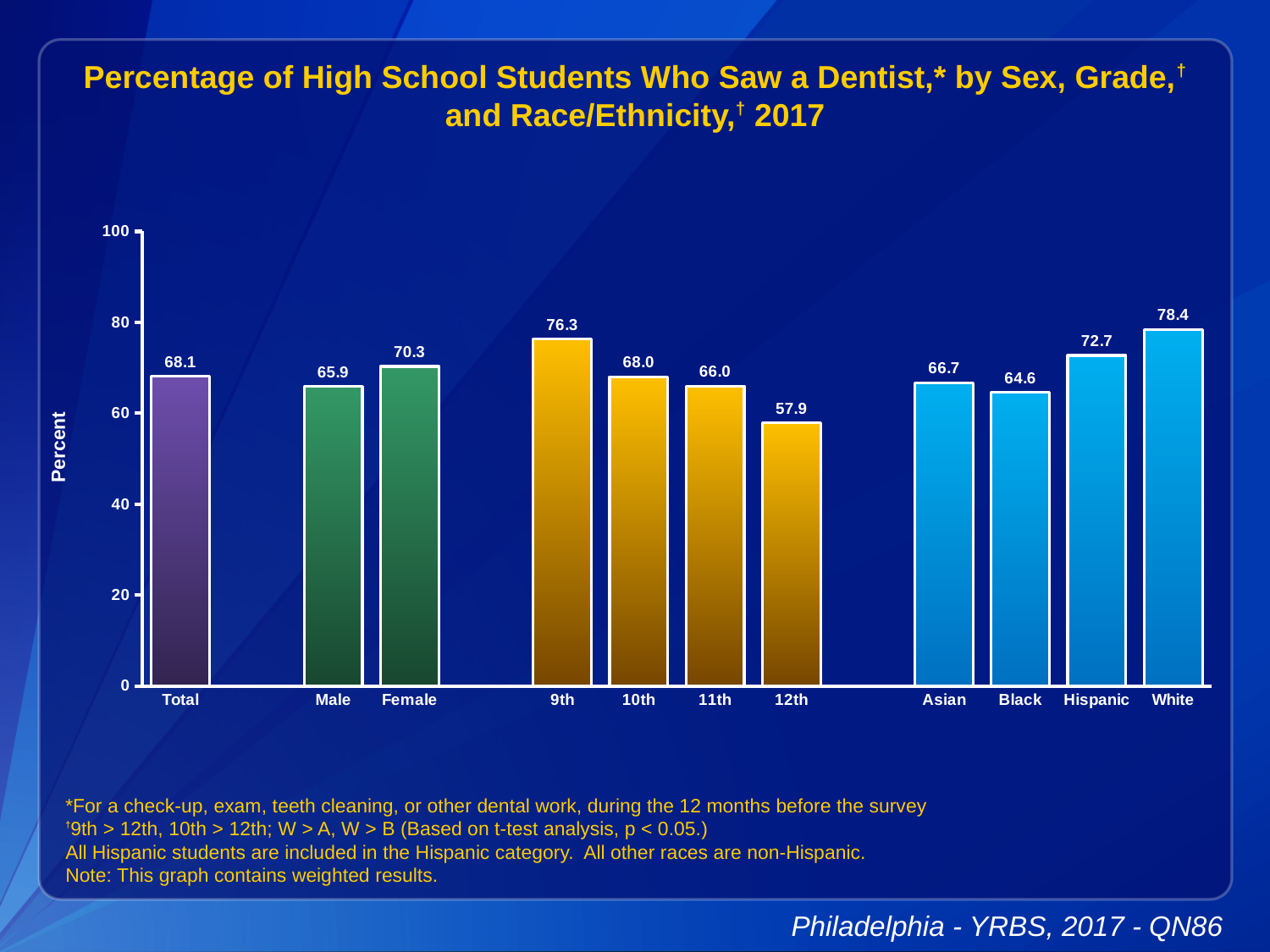
Do the values rise or fall from 9th grade to 12th grade? fall What is the difference between the Female and Male values? 4.4 What is the difference between the White and Black values? 13.8 What percentage of female students saw a dentist? 70.3 How many categories are shown on the x axis? 11 What is the value for 12th grade students? 57.9 What kind of chart is this? bar chart Which category has the lowest value? 12th What is the value for Total? 68.1 Which category has the highest value? White Which is larger, the value for Hispanic or the value for Asian? Hispanic Is the value for 9th grade greater or less than 80? less